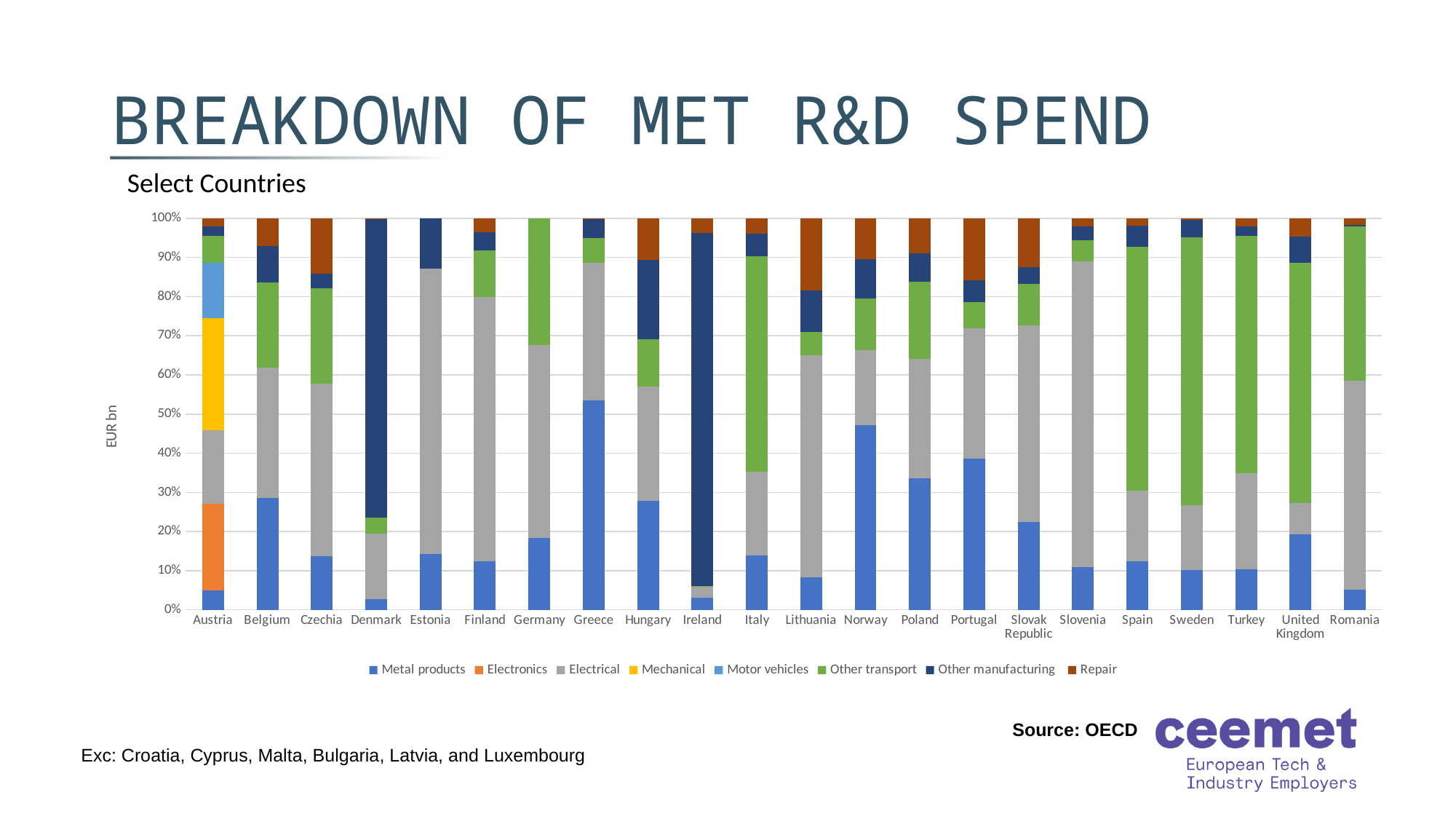
How many series does the chart legend list? 8 Is the Metal products share for Belgium greater or less than 30%? less Is the Other manufacturing share for Ireland greater or less than 80%? greater How many countries are shown on the x axis of the chart? 22 Is the Metal products share for Greece greater or less than 50%? greater Which country has the largest Other manufacturing share of its bar? Ireland Which country has the larger Metal products share, Greece or Belgium? Greece Which country is the only one with a Mechanical segment in its bar? Austria What kind of chart is shown on the slide? Stacked bar chart What is the title of the slide containing the chart? BREAKDOWN OF MET R&D SPEND Which country has the largest Metal products share of its bar? Greece